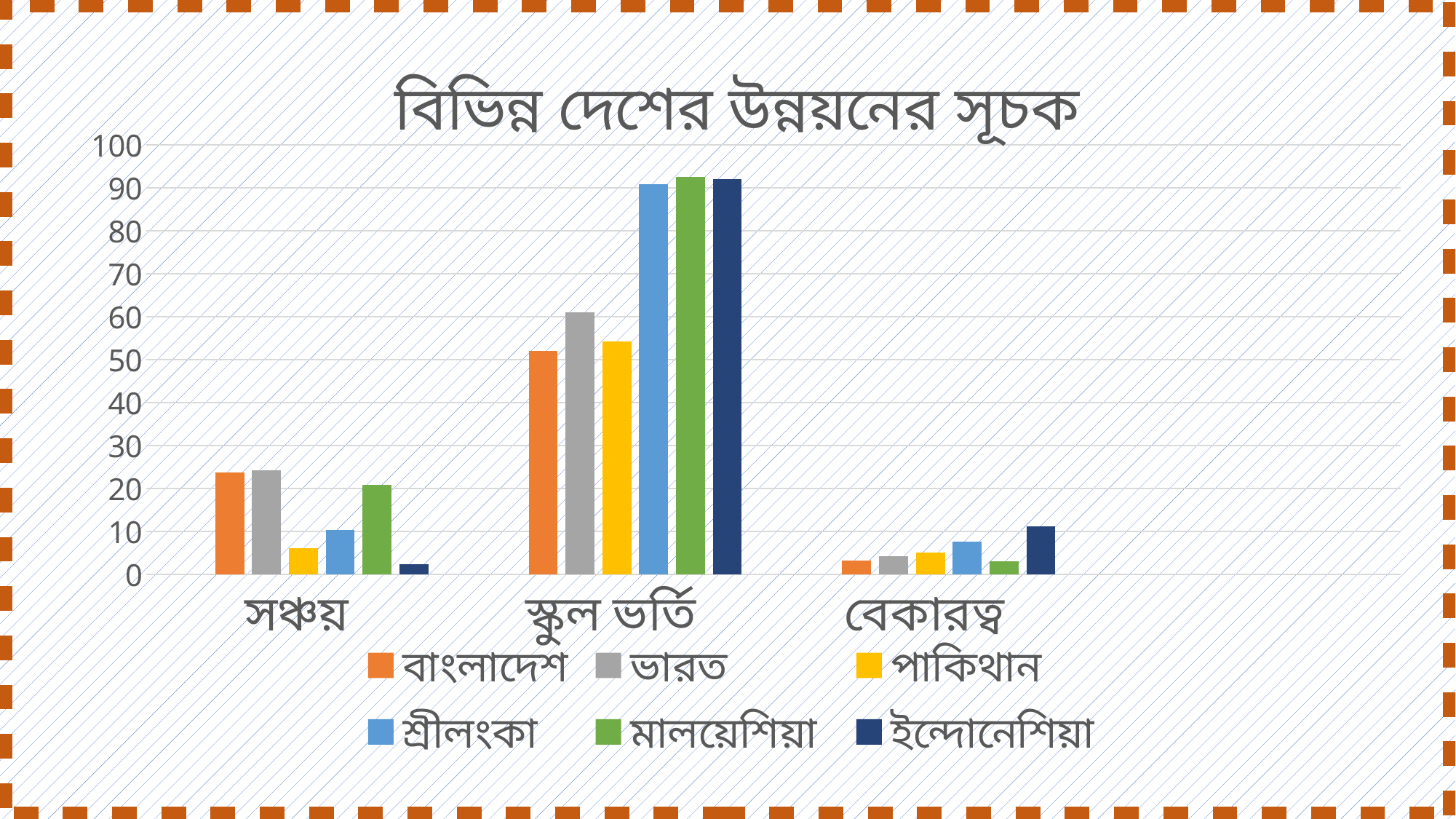
What kind of chart is shown on the slide? bar chart Is the value for বাংলাদেশ in সঞ্চয় greater or less than 20? greater Which country has the lowest value for সঞ্চয়? ইন্দোনেশিয়া What is the title of the chart? বিভিন্ন দেশের উন্নয়নের সূচক Which series is shown in orange in the legend? বাংলাদেশ Is the value for শ্রীলংকা in স্কুল ভর্তি greater or less than 80? greater Which country has the highest value for বেকারত্ব? ইন্দোনেশিয়া How many categories are shown on the x axis of the chart? 3 For সঞ্চয়, which is larger: the value for মালয়েশিয়া or the value for পাকিস্তান? মালয়েশিয়া Is the value for পাকিস্তান in সঞ্চয় greater or less than 10? less How many series does the legend list? 6 For স্কুল ভর্তি, which is larger: the value for ভারত or the value for বাংলাদেশ? ভারত